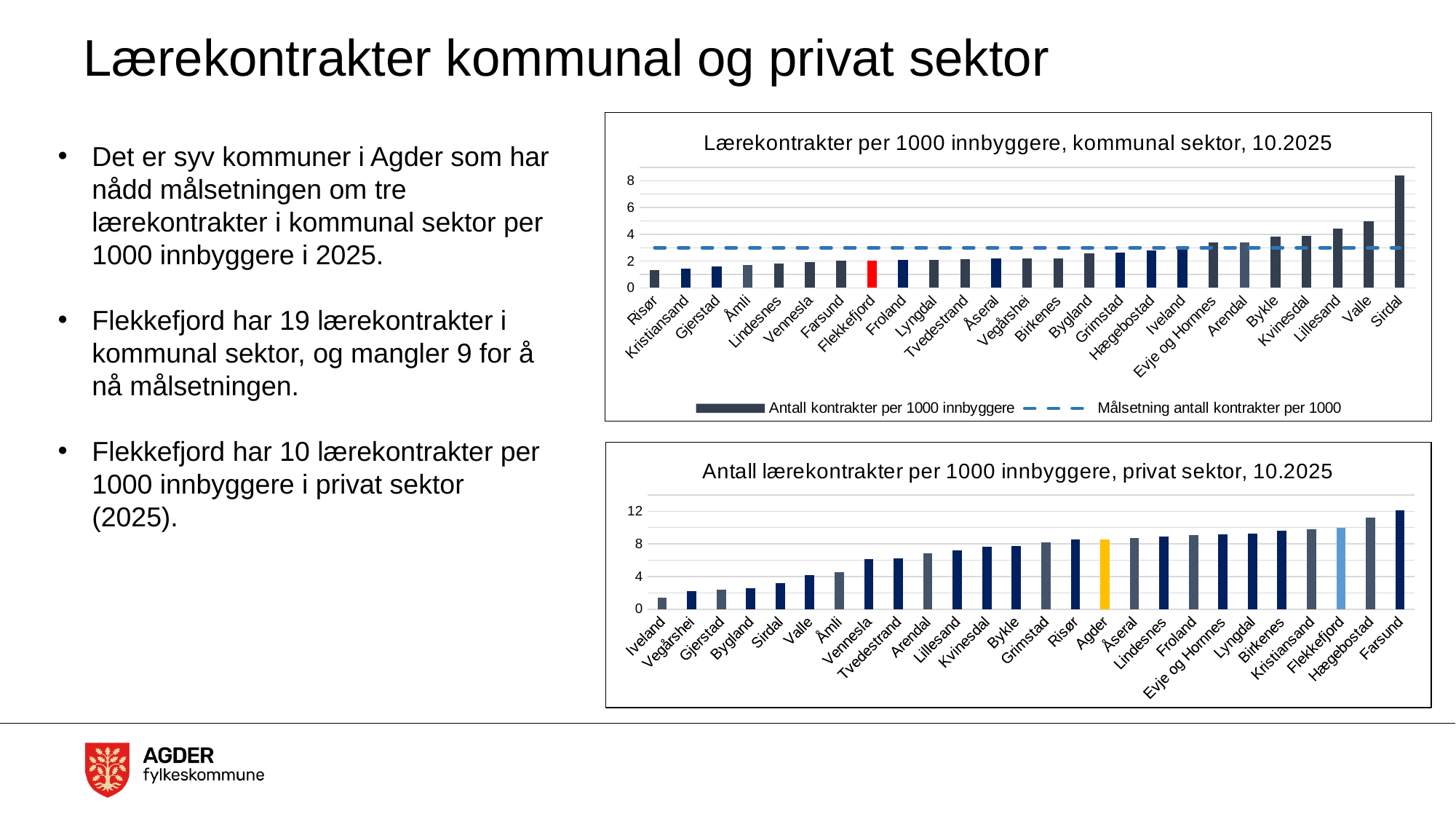
In the top chart (kommunal sektor), how many series does the legend list? 2 What kind of chart is the bottom chart (privat sektor)? Bar chart In the bottom chart (privat sektor), do the values rise or fall from left to right along the x axis? Rise In the top chart (kommunal sektor), what colour is the bar for Flekkefjord? Red In the top chart (kommunal sektor), is the value for Sirdal greater or less than 6? greater In the bottom chart (privat sektor), is the value for Farsund greater or less than 8? greater In the top chart (kommunal sektor), which municipality has the highest number of lærekontrakter per 1000 innbyggere? Sirdal In the bottom chart (privat sektor), which municipality has the lowest value? Iveland In the top chart (kommunal sektor), which municipality has the lowest number of lærekontrakter per 1000 innbyggere? Risør In the top chart (kommunal sektor), is the value for Flekkefjord greater or less than 4? less In the bottom chart (privat sektor), which municipality has the highest value? Farsund In the bottom chart (privat sektor), how many categories are shown on the x axis? 26